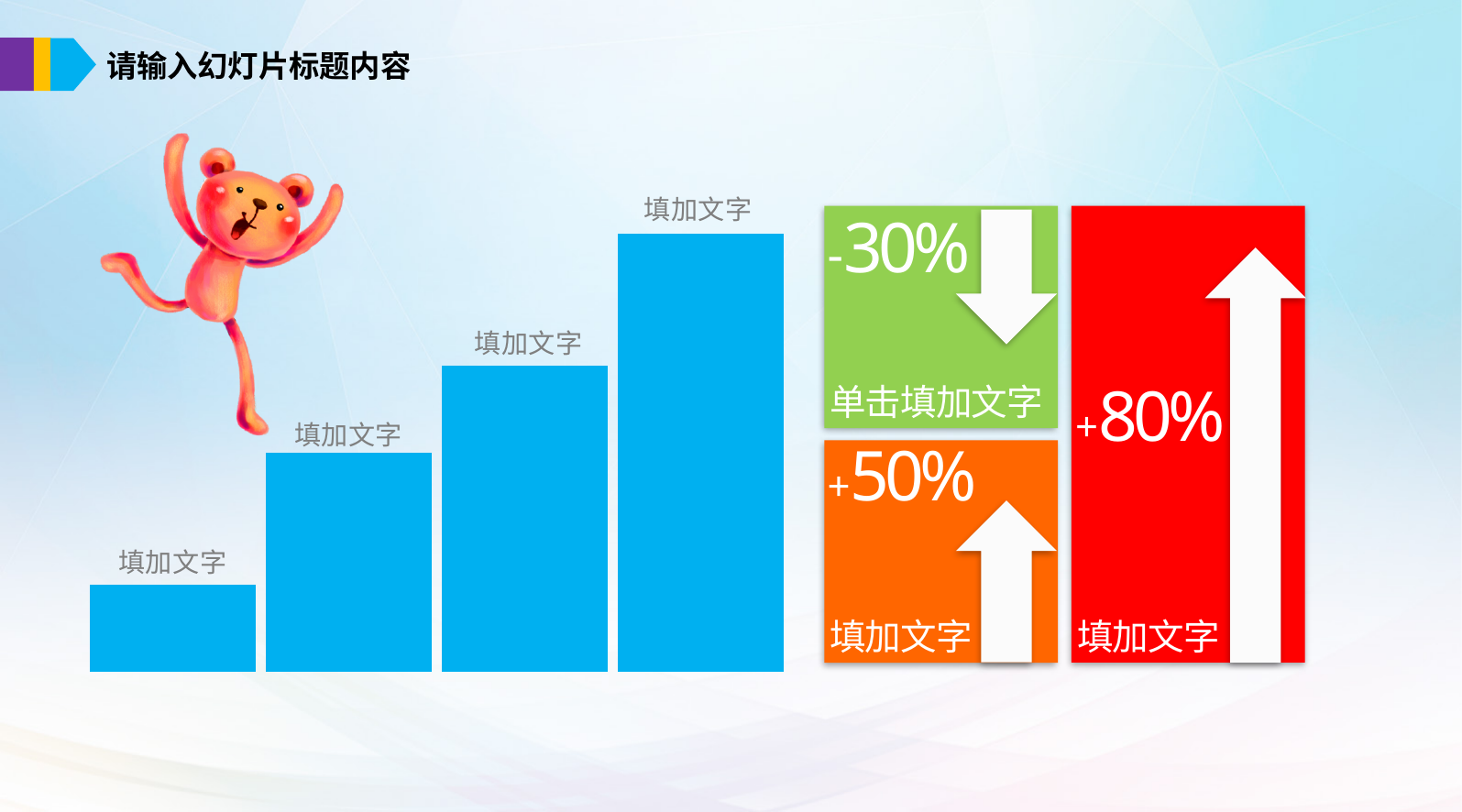
What label text appears above each bar in the chart? 填加文字 Which is taller, the leftmost bar or the rightmost bar? the rightmost bar Which bar in the chart is the tallest? the rightmost bar What colour are the bars in the chart? blue Which bar in the chart is the shortest? the leftmost bar How many bars does the bar chart have? 4 What kind of chart is shown on the slide? bar chart Do the bar values rise or fall from left to right across the chart? rise Which is taller, the second bar from the left or the third bar from the left? the third bar from the left